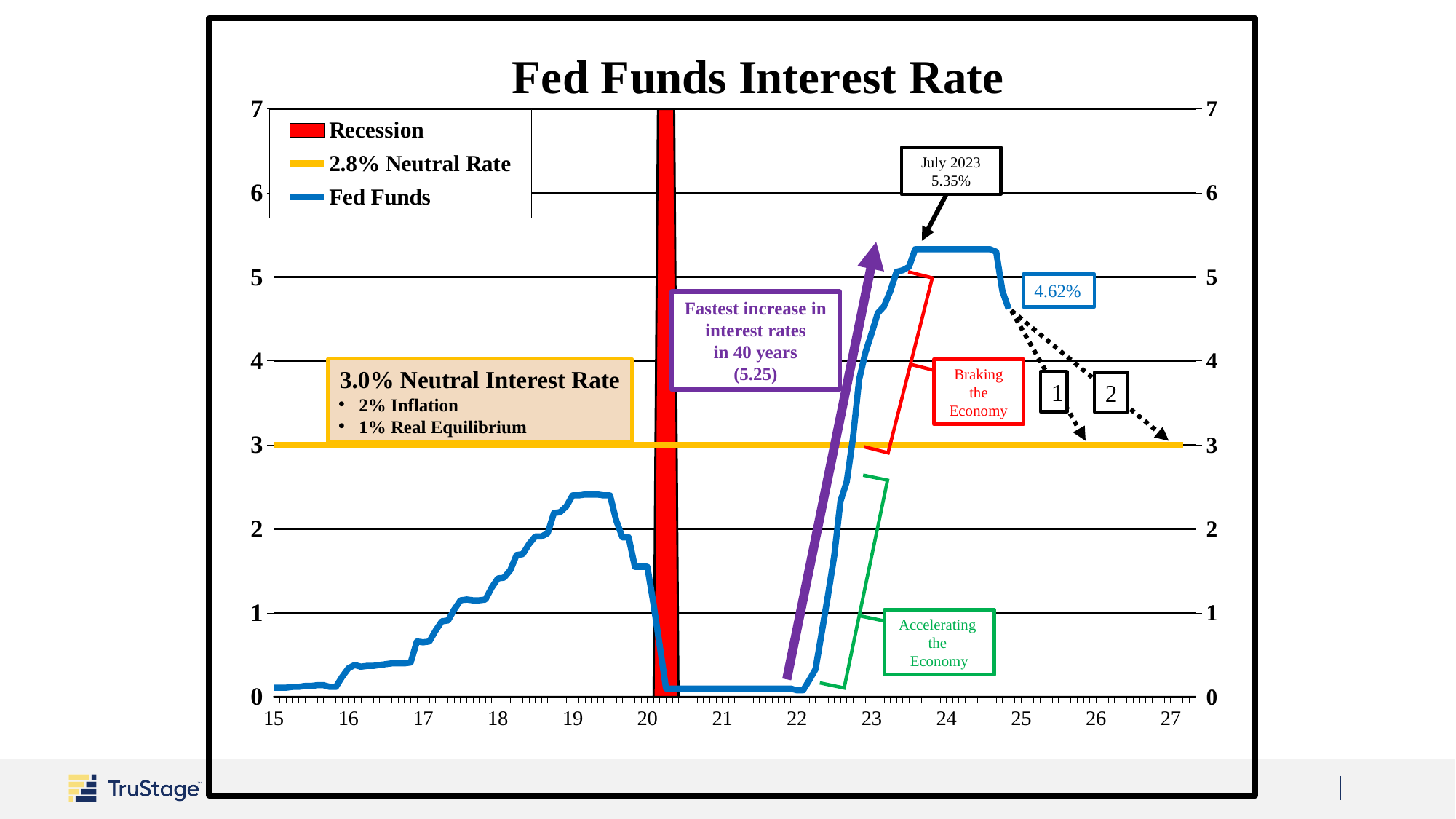
Is the Fed Funds rate at the start of 2021 greater or less than 1? less What does the red shaded area on the chart represent? Recession Is the Fed Funds rate at the start of 2017 greater or less than 1? less How many series does the legend list? 3 What is the title of the chart? Fed Funds Interest Rate Is the Fed Funds rate at the start of 2024 greater or less than 5? greater How many year labels are shown on the x axis? 13 What kind of chart is shown on the slide? line chart Does the Fed Funds line rise or fall between 22 and 23 on the x axis? rise What Fed Funds rate is labelled for July 2023? 5.35% What value is shown in the blue annotation box near year 25? 4.62% What neutral rate value is given in the legend? 2.8%